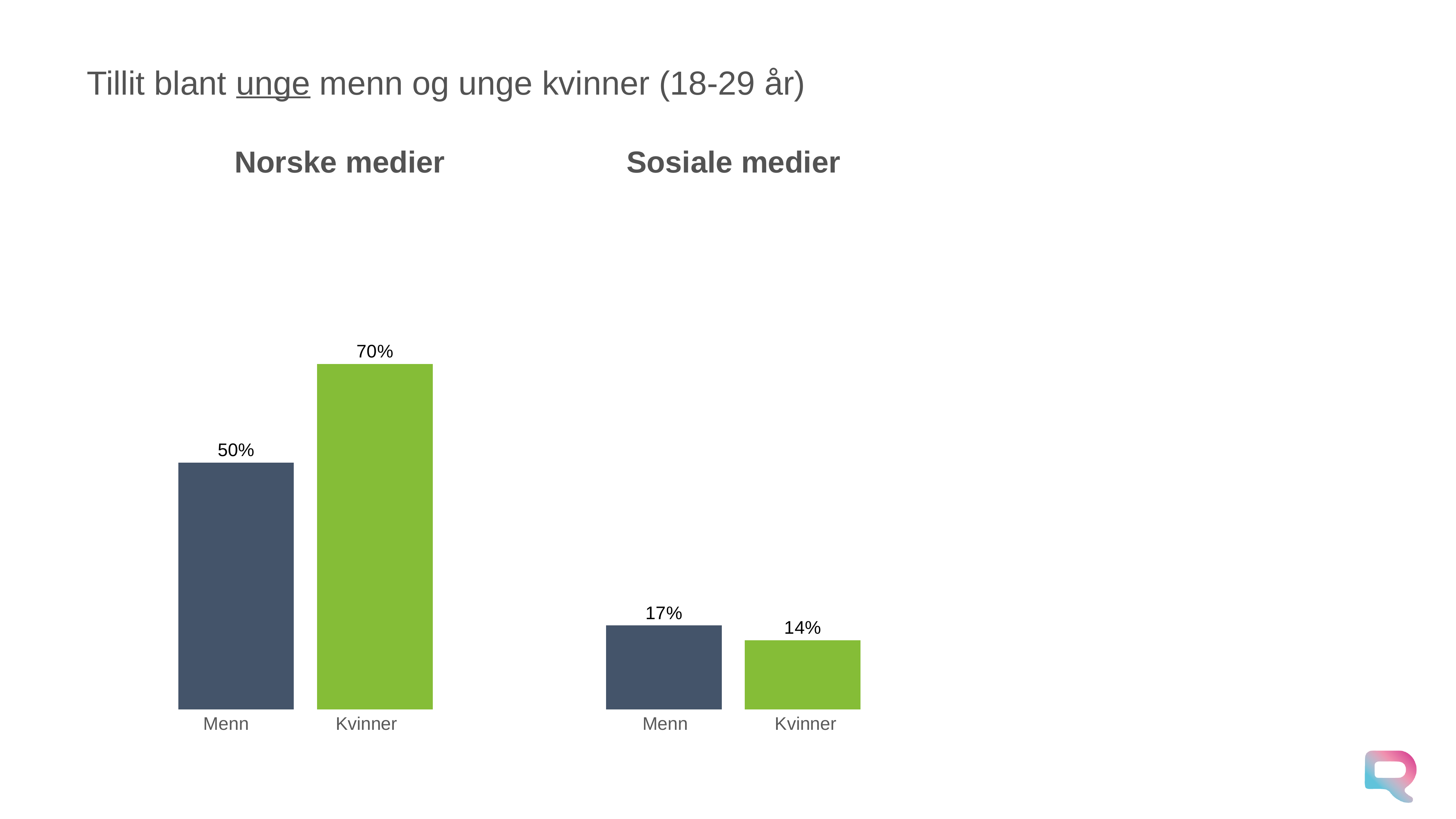
What is the title of the chart on the left? Norske medier In the Norske medier chart, what is the value for Kvinner? 70% In the Sosiale medier chart, what is the difference between the values for Menn and Kvinner? 3% How many categories does the Norske medier chart show? 2 In the Norske medier chart, which category has the highest value? Kvinner In the Norske medier chart, what is the difference between the values for Kvinner and Menn? 20% In the Sosiale medier chart, which category has the lowest value? Kvinner In the Sosiale medier chart, what is the value for Kvinner? 14% In the Norske medier chart, what is the value for Menn? 50% In the Sosiale medier chart, what is the value for Menn? 17% In the Sosiale medier chart, which is larger, the value for Menn or the value for Kvinner? Menn What kind of chart is the Sosiale medier chart? Bar chart